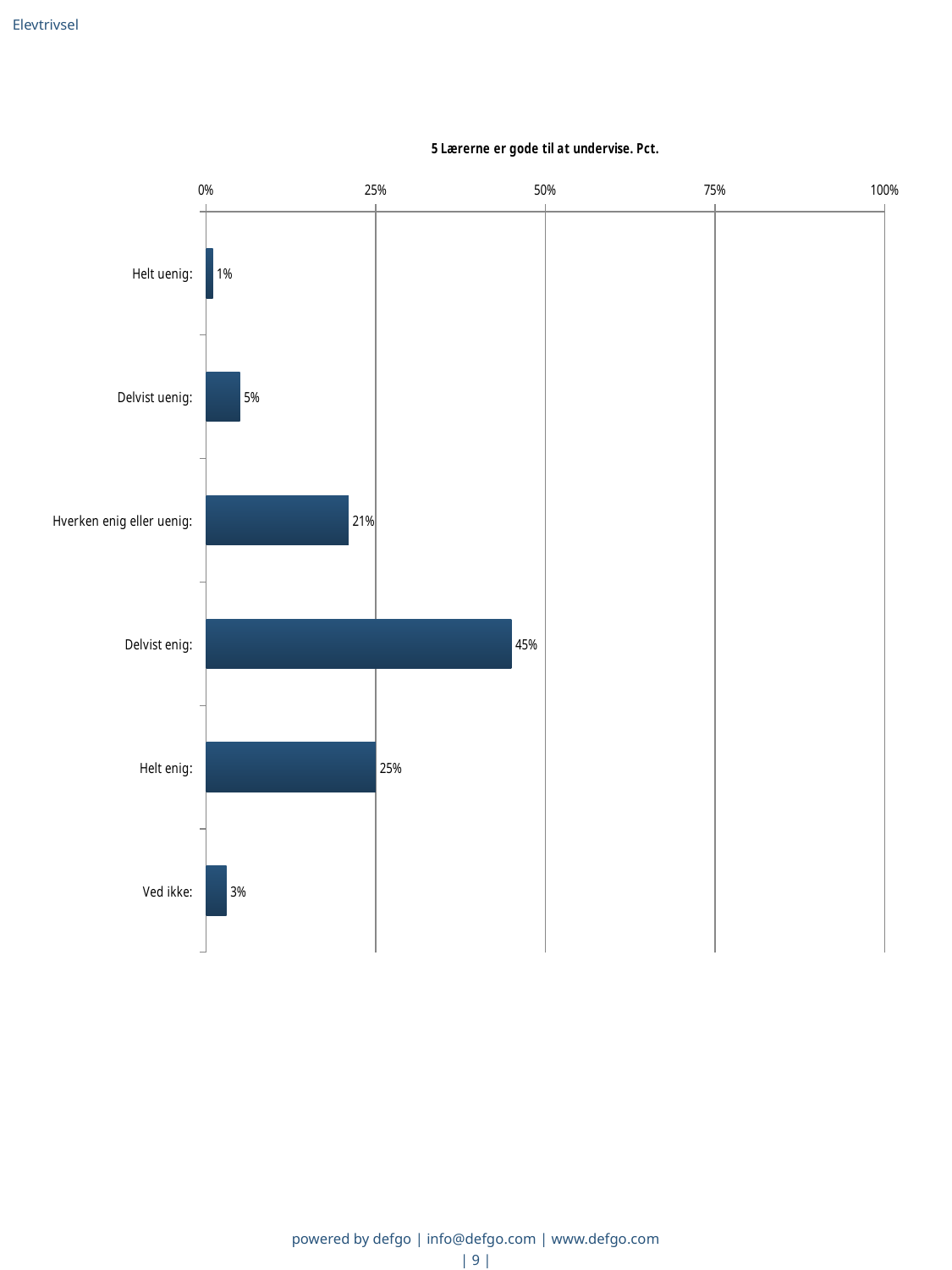
How many categories are shown in the chart? 6 What is the title of the chart? 5 Lærerne er gode til at undervise. Pct. Which category has the lowest value? Helt uenig What is the value for "Hverken enig eller uenig"? 21% What is the value for "Delvist enig"? 45% What is the value for "Ved ikke"? 3% What is the difference between the values for "Delvist enig" and "Helt enig"? 20% Which is larger, the value for "Helt enig" or the value for "Hverken enig eller uenig"? Helt enig Is the value for "Delvist enig" greater or less than 50%? less What kind of chart is shown on the slide? bar chart What is the maximum value shown on the horizontal axis? 100% Which category has the highest value? Delvist enig